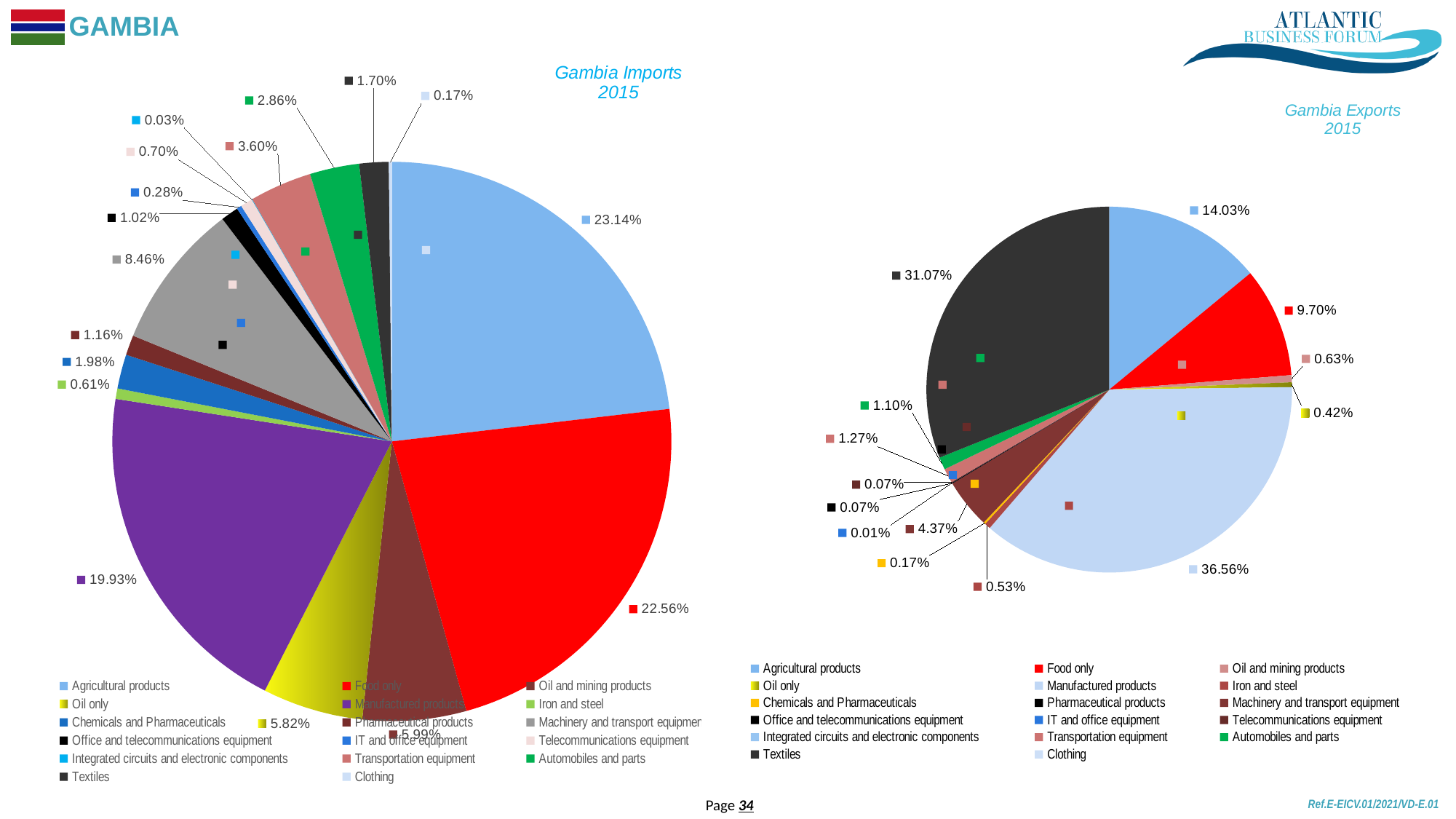
In the Gambia Imports 2015 chart, what is the difference between the shares of Agricultural products and Food only? 0.58 percentage points In the Gambia Imports 2015 chart, what share do Agricultural products have? 23.14% In the Gambia Exports 2015 chart, what share do Manufactured products have? 36.56% Is the share of Agricultural products larger in the Gambia Imports 2015 chart or the Gambia Exports 2015 chart? Gambia Imports 2015 In the Gambia Exports 2015 chart, which category has the largest share? Manufactured products In the Gambia Imports 2015 chart, what share do Manufactured products have? 19.93% What kind of chart is the Gambia Imports 2015 chart? Pie chart In the Gambia Exports 2015 chart, what share do Textiles have? 31.07% In the Gambia Imports 2015 chart, what share does Machinery and transport equipment have? 8.46% In the Gambia Exports 2015 chart, what is the difference between the shares of Manufactured products and Textiles? 5.49 percentage points In the Gambia Imports 2015 chart, which category has the largest share? Agricultural products In the Gambia Imports 2015 chart, what share does Food only have? 22.56%